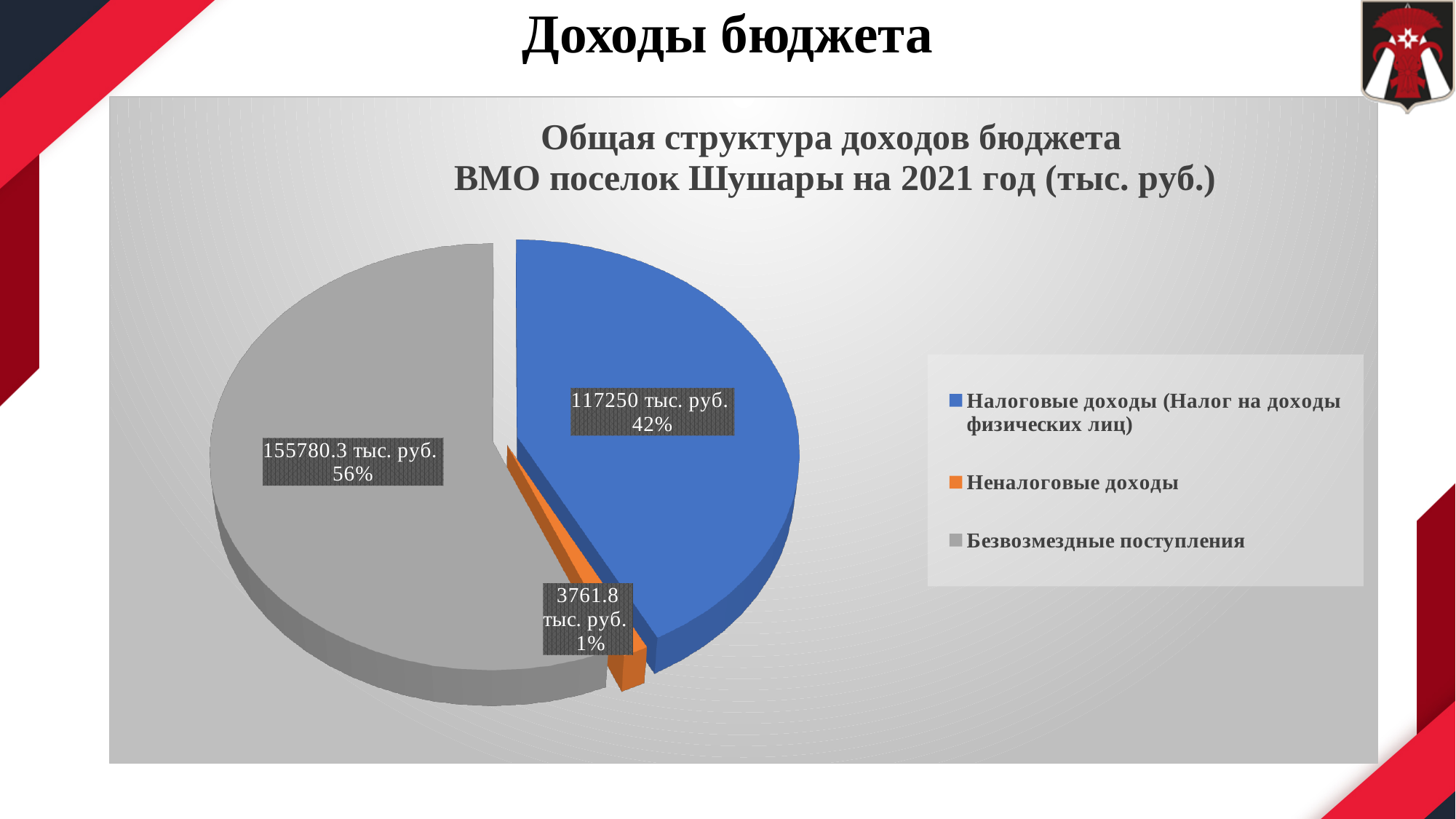
What is the value for Налоговые доходы (Налог на доходы физических лиц)? 117250 тыс. руб. What is the value for Безвозмездные поступления? 155780.3 тыс. руб. How many categories does the pie chart show? 3 What is the value for Неналоговые доходы? 3761.8 тыс. руб. Which category has the smallest slice of the pie? Неналоговые доходы What share of the pie does Налоговые доходы represent? 42% What share of the pie does Безвозмездные поступления represent? 56% What share of the pie does Неналоговые доходы represent? 1% Which category has the largest slice of the pie? Безвозмездные поступления What type of chart is shown on the slide? Pie chart Which colour represents Неналоговые доходы in the legend? Orange What is the difference between Безвозмездные поступления and Налоговые доходы in тыс. руб.? 38530.3 тыс. руб.